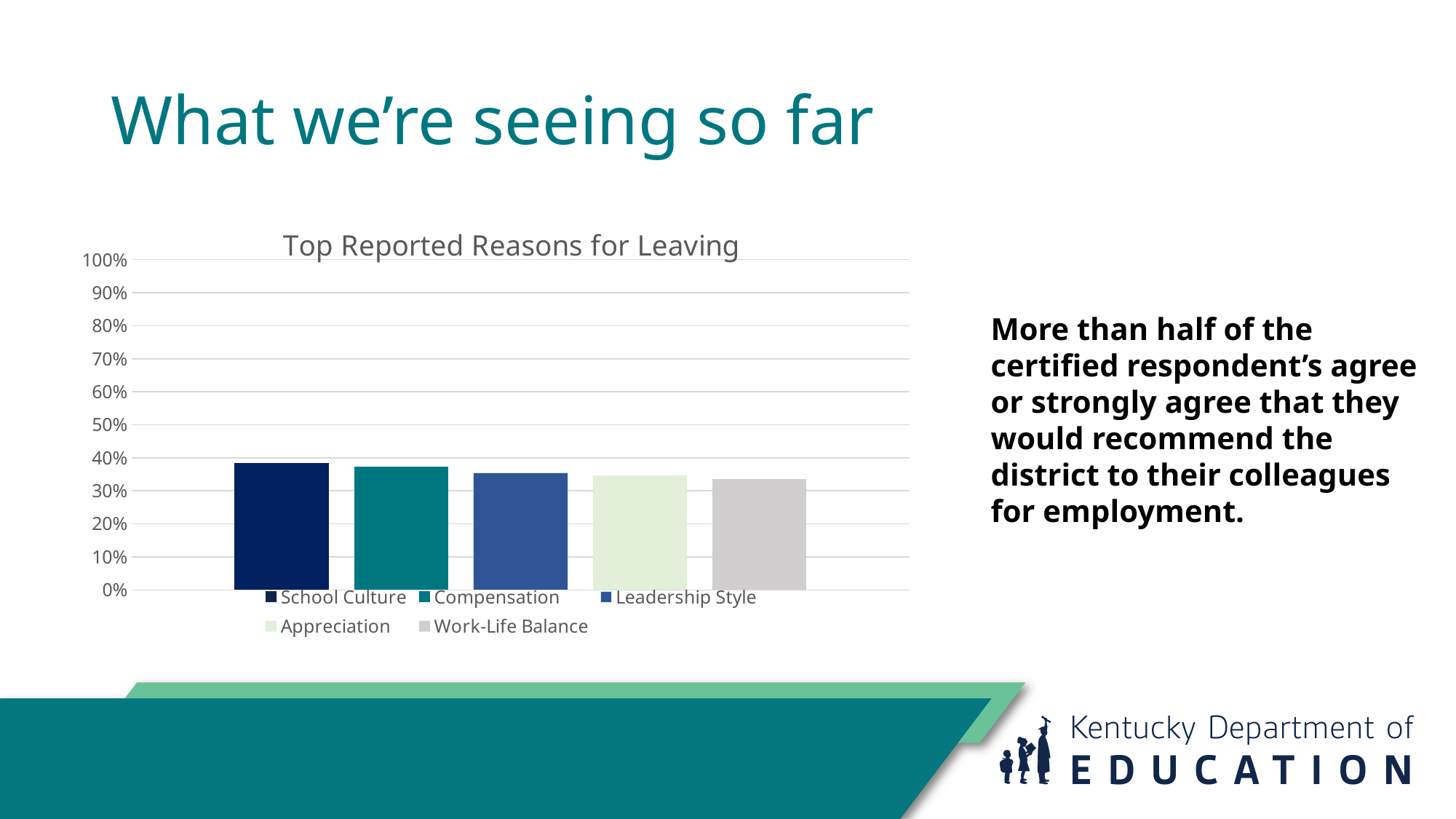
Which is larger, the value for Compensation or the value for Work-Life Balance? Compensation Is the value for Compensation greater or less than 50%? less What is the title of the chart? Top Reported Reasons for Leaving Is the value for School Culture greater or less than 40%? less Do the bar values rise or fall from left to right across the chart? Fall How many bars are plotted in the chart? 5 Is the value for Work-Life Balance greater or less than 30%? greater Which is larger, the value for School Culture or the value for Work-Life Balance? School Culture What kind of chart is shown on the slide? Bar chart Which legend entry is shown in teal? Compensation How many series does the chart's legend list? 5